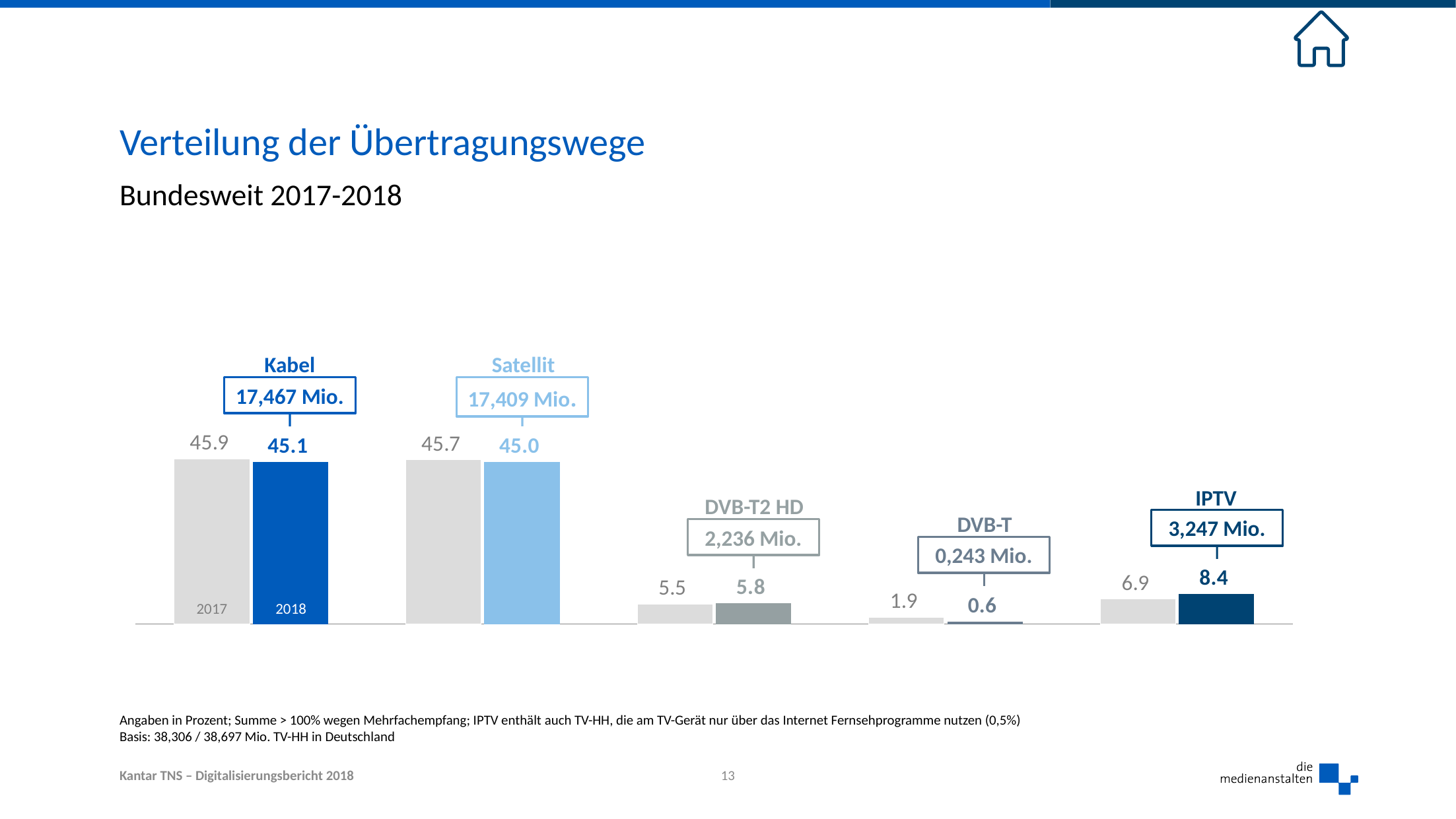
What is the 2018 value for Kabel? 45.1 What is the 2017 value for Satellit? 45.7 What kind of chart is shown on the slide? bar chart Is the 2018 value for DVB-T2 HD larger or smaller than its 2017 value? larger Which transmission path has the lowest 2018 value? DVB-T What household figure in millions is shown in the box above IPTV? 3,247 Mio. What is the 2018 value for IPTV? 8.4 What is the difference between the 2017 and 2018 values for IPTV? 1.5 Which transmission path has the highest 2018 value? Kabel How many transmission paths (categories) are shown in the chart? 5 What is the 2017 value for DVB-T? 1.9 What is the difference between the 2017 and 2018 values for Kabel? 0.8